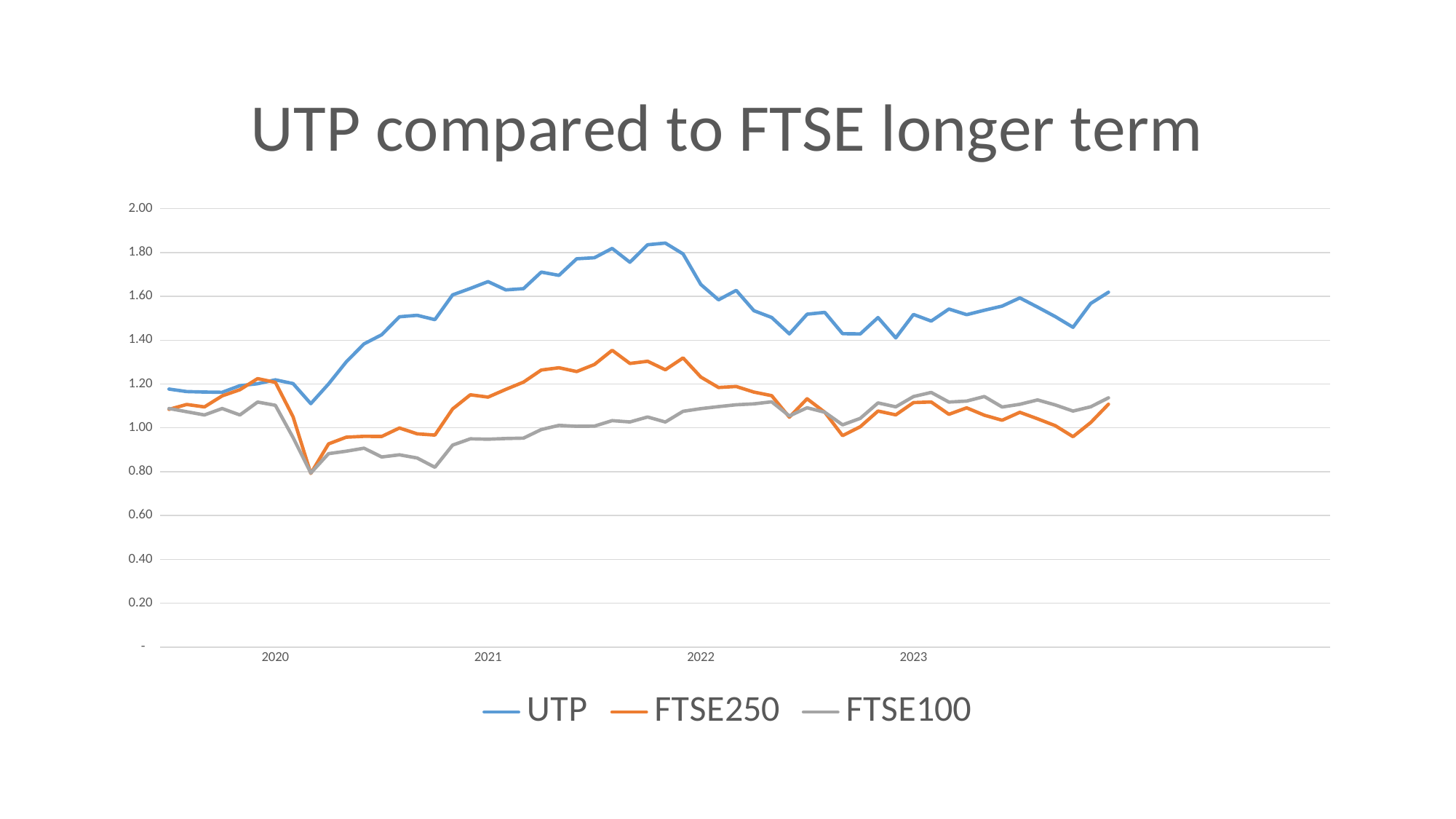
Which series has the lowest value at the 2021 tick? FTSE100 Does the UTP line rise or fall between the 2020 tick and the 2021 tick? rise Is the value for UTP at the 2022 tick greater or less than 1.40? greater How many year labels are shown on the x axis? 4 How many series does the legend list? 3 At the 2022 tick, which is larger, UTP or FTSE250? UTP Is the highest value reached by UTP greater or less than 2.00? less Which series is drawn in orange? FTSE250 What is the title of the chart? UTP compared to FTSE longer term Is the value for FTSE100 at the 2021 tick greater or less than 1.00? less Which series reaches the highest value on the chart? UTP What kind of chart is shown on the slide? line chart